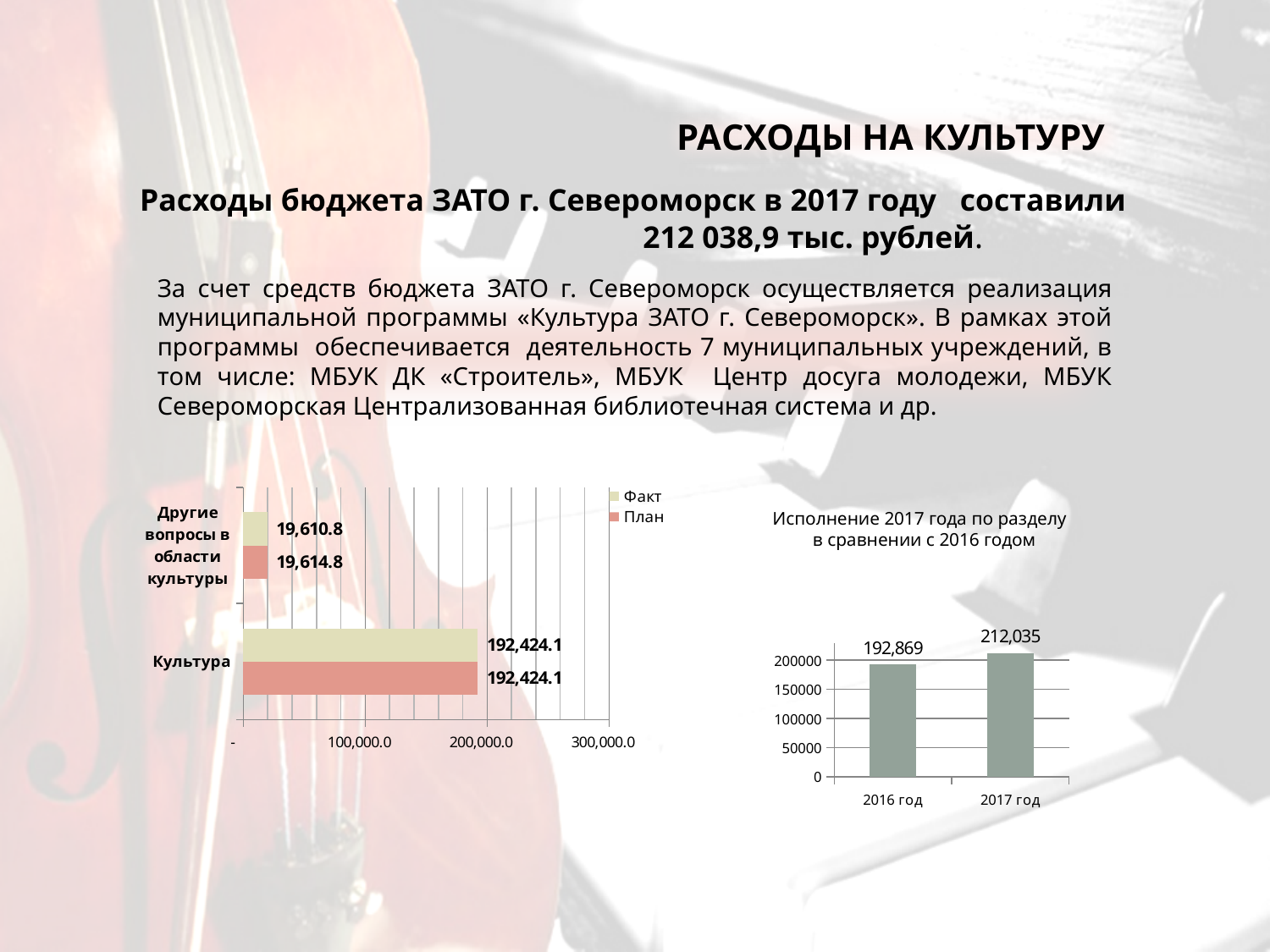
In the left chart, what is the difference between the План and Факт values for Другие вопросы в области культуры? 4.0 In the left chart, what is the План value for Другие вопросы в области культуры? 19,614.8 In the left chart, what is the Факт value for Культура? 192,424.1 In the left chart, which category has the higher Факт value, Культура or Другие вопросы в области культуры? Культура In the chart titled 'Исполнение 2017 года по разделу в сравнении с 2016 годом', what is the difference between the 2017 год and 2016 год values? 19,166 In the chart titled 'Исполнение 2017 года по разделу в сравнении с 2016 годом', what is the value for 2017 год? 212,035 In the left chart, what kind of chart is shown? Bar chart In the chart titled 'Исполнение 2017 года по разделу в сравнении с 2016 годом', which year has the higher value? 2017 год In the left chart, how many series does the legend list? 2 In the chart titled 'Исполнение 2017 года по разделу в сравнении с 2016 годом', how many categories are shown on the x axis? 2 In the left chart, what is the Факт value for Другие вопросы в области культуры? 19,610.8 In the chart titled 'Исполнение 2017 года по разделу в сравнении с 2016 годом', what is the value for 2016 год? 192,869